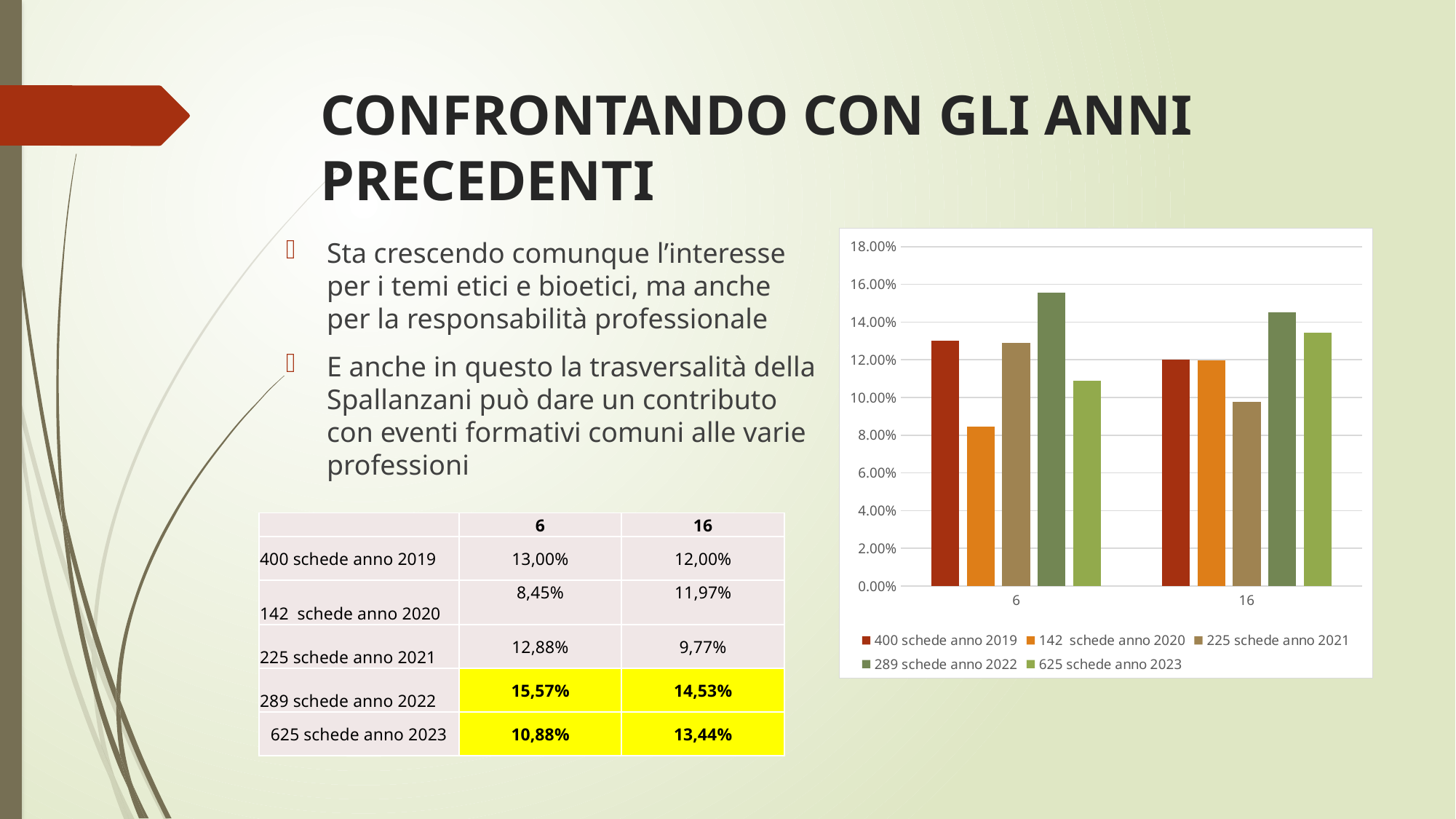
What is the difference between 289 schede anno 2022 and 625 schede anno 2023 in category 6? 4,69% How many categories are shown on the x axis of the chart? 2 What is the value for 289 schede anno 2022 in category 6? 15,57% What is the highest value shown on the chart's y axis? 18.00% Which series has the lowest bar in category 6? 142 schede anno 2020 Which series has the lowest bar in category 16? 225 schede anno 2021 What is the value for 625 schede anno 2023 in category 16? 13,44% What kind of chart is shown on the slide? bar chart For 625 schede anno 2023, is the bar larger in category 6 or category 16? 16 Which series has the highest bar in category 6? 289 schede anno 2022 How many series does the chart legend list? 5 Is the value for 142 schede anno 2020 in category 6 greater or less than 10.00%? less